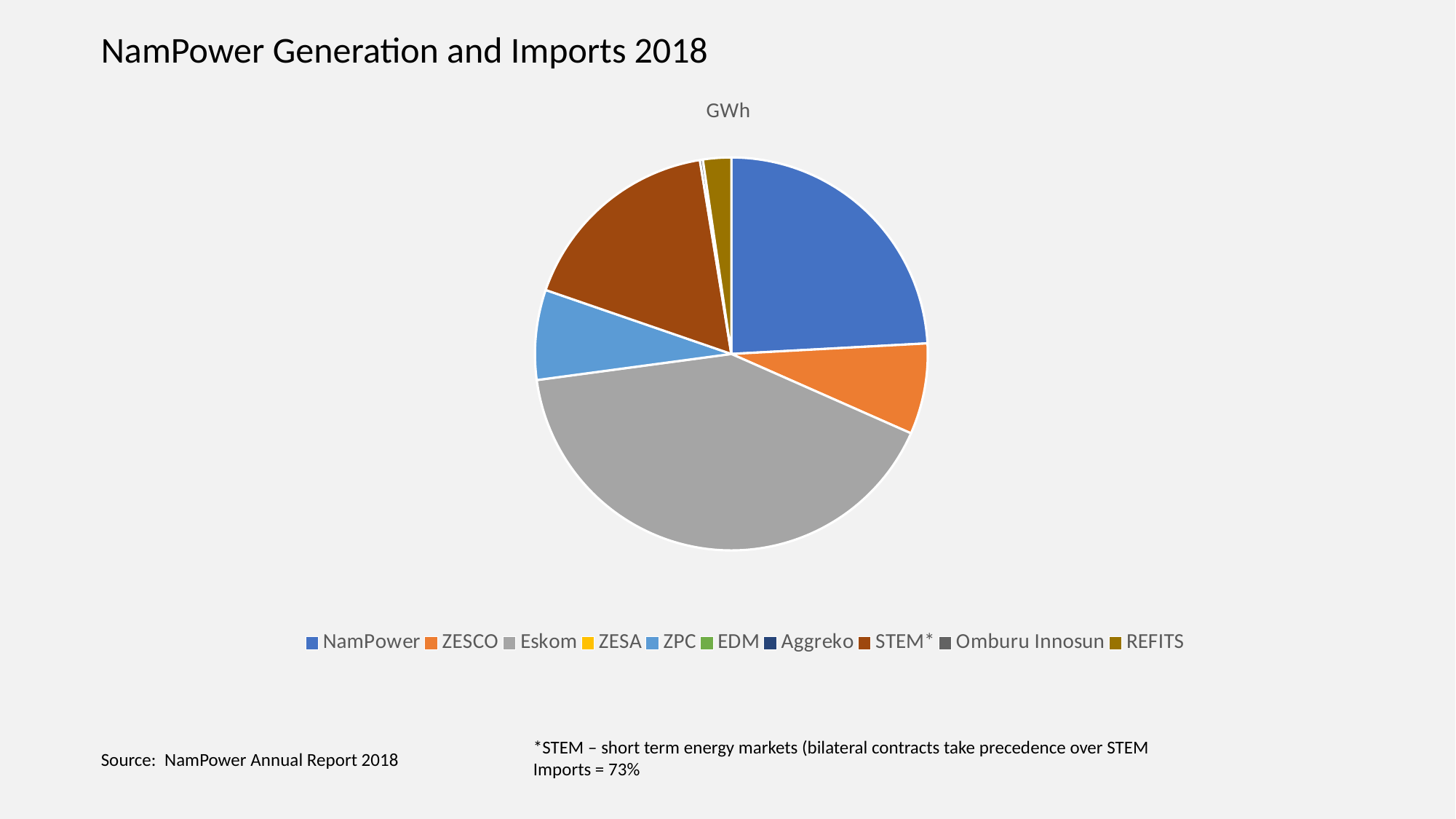
Which slice is larger, ZPC or REFITS? ZPC Which slice is larger, NamPower or ZESCO? NamPower Which slice is larger, STEM* or ZPC? STEM* What unit is given in the chart title above the pie? GWh What is the title of the slide? NamPower Generation and Imports 2018 Which category has the largest slice of the pie? Eskom What kind of chart is shown on the slide? pie chart How many categories does the legend list? 10